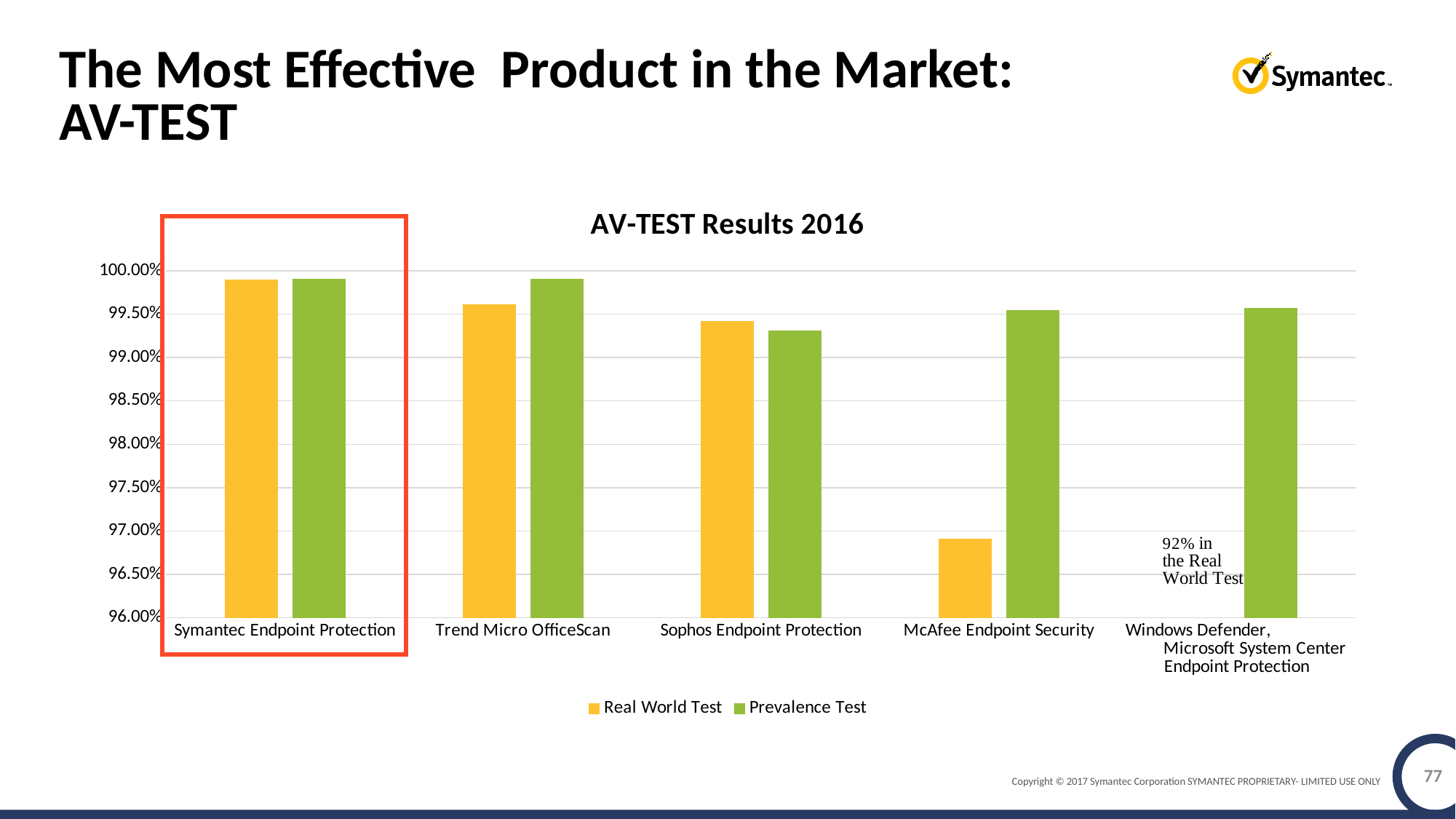
According to the annotation on the chart, what was the Real World Test result for Windows Defender, Microsoft System Center Endpoint Protection? 92% Is the Real World Test value for Trend Micro OfficeScan greater or less than 99.00%? greater Is the Prevalence Test value for Sophos Endpoint Protection greater or less than 99.00%? greater How many series does the legend of the AV-TEST Results 2016 chart list? 2 Which product has the lowest Prevalence Test value? Sophos Endpoint Protection Is the Real World Test value for McAfee Endpoint Security greater or less than 97.50%? less Which has the larger Real World Test value, Sophos Endpoint Protection or McAfee Endpoint Security? Sophos Endpoint Protection For Trend Micro OfficeScan, which is larger, the Real World Test or the Prevalence Test value? Prevalence Test How many products are shown on the x axis of the chart? 5 What is the title of the chart? AV-TEST Results 2016 Which colour represents the Real World Test series in the chart? yellow What kind of chart is shown on the slide? bar chart